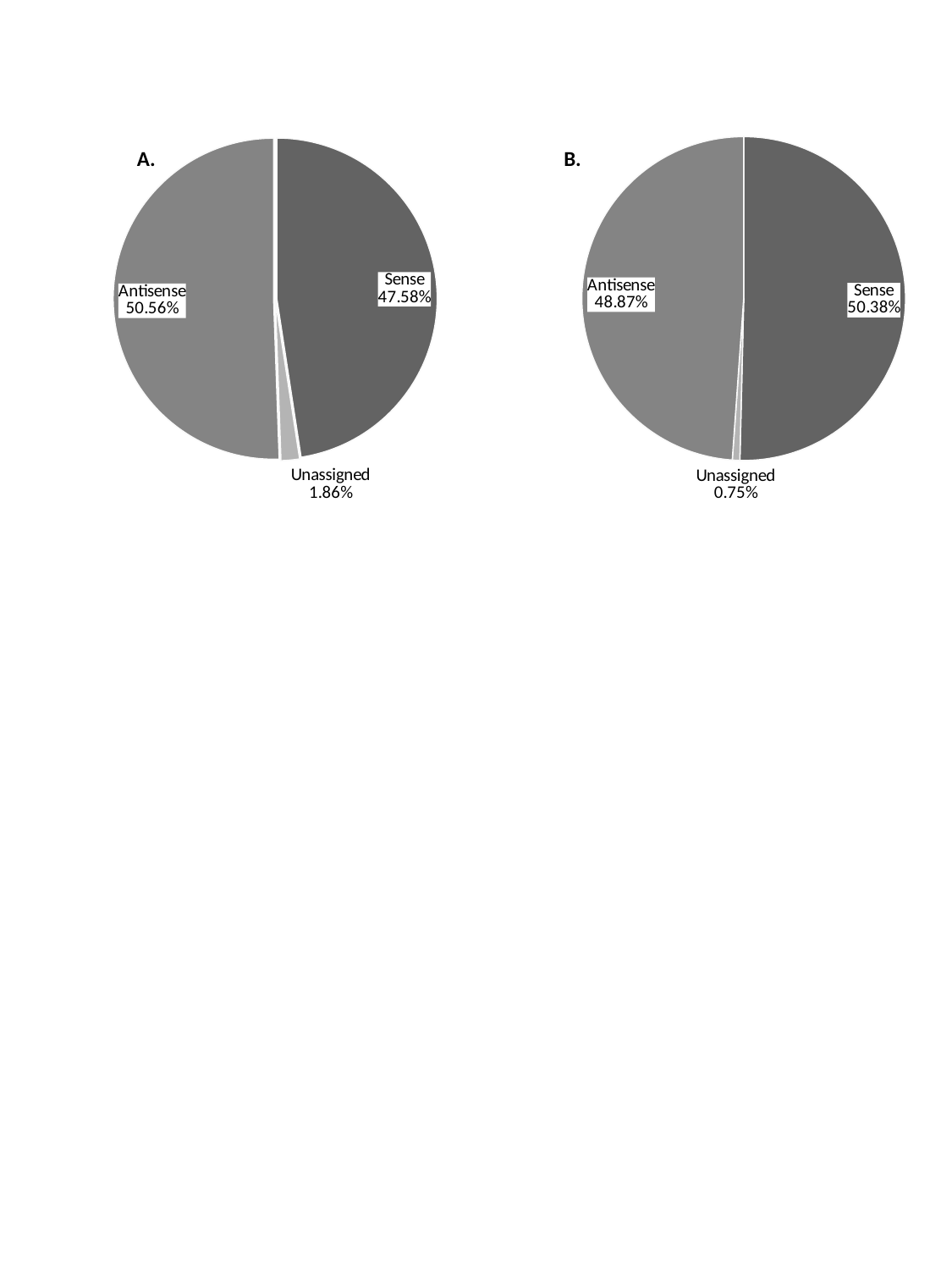
In pie chart B, what percentage is labelled for Unassigned? 0.75% In pie chart B, which slice is the smallest? Unassigned In pie chart A, what percentage is labelled for Antisense? 50.56% In pie chart A, what percentage is labelled for Unassigned? 1.86% What type of chart is chart B? Pie chart In pie chart B, what percentage is labelled for Antisense? 48.87% How many slices does pie chart A have? 3 In pie chart A, what percentage is labelled for Sense? 47.58% In pie chart B, which is larger, Sense or Antisense? Sense In pie chart A, which slice is the largest? Antisense In pie chart B, what percentage is labelled for Sense? 50.38% In pie chart A, what is the difference between the Antisense and Sense percentages? 2.98%